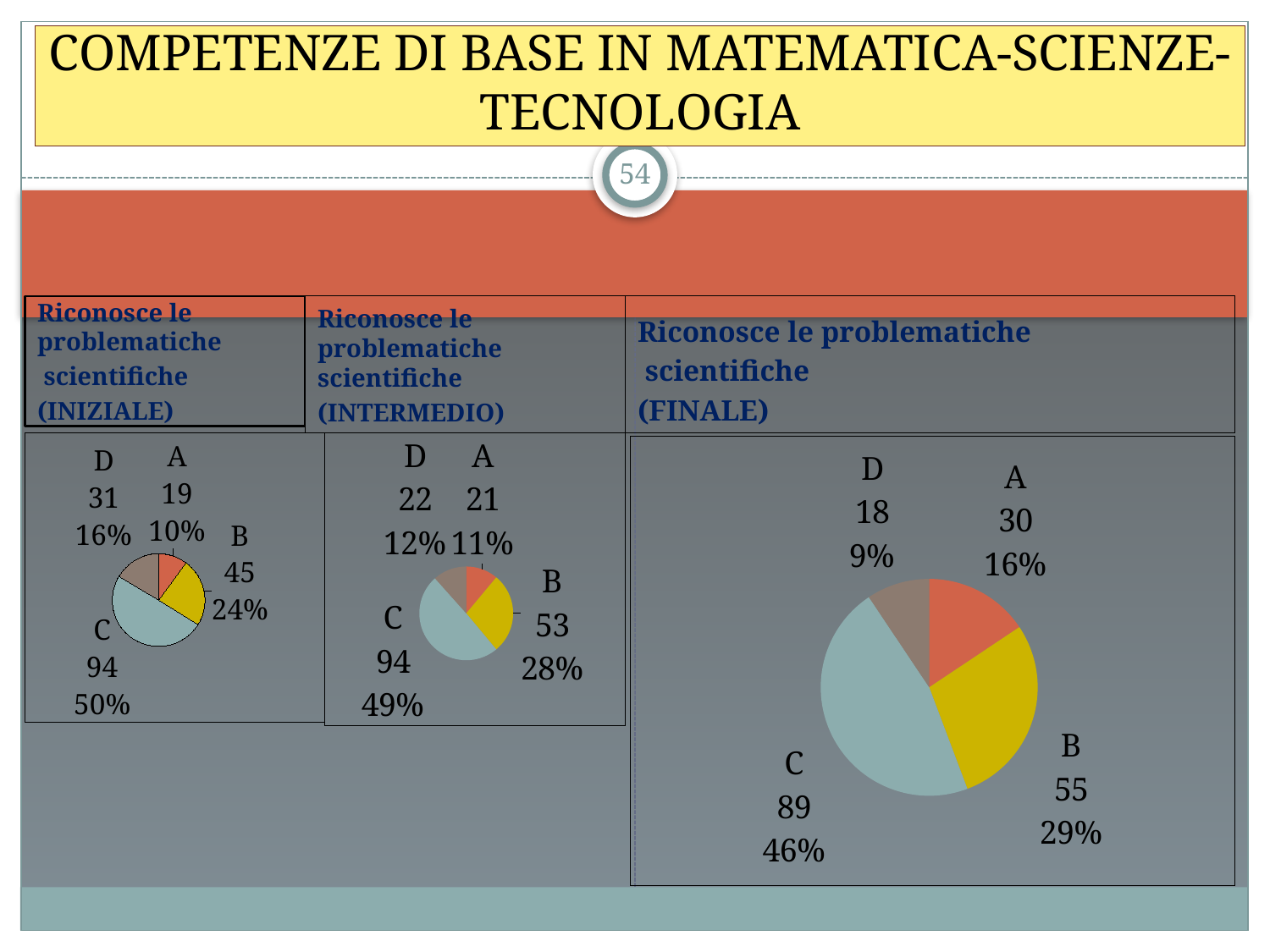
In the INTERMEDIO pie chart, what is the value for category B? 53 How many categories does the INTERMEDIO pie chart show? 4 In the FINALE pie chart, which category has the largest value? C In the INTERMEDIO pie chart, which category has the smallest value? A In the INTERMEDIO pie chart, what is the difference between the values for C and D? 72 In the FINALE pie chart, what is the value for category D? 18 In the FINALE pie chart, what is the difference between the values for B and A? 25 In the INIZIALE pie chart, what is the value for category C? 94 What kind of chart is used for the FINALE data? Pie chart In the FINALE pie chart, what share of the pie does category C represent? 46% In the INIZIALE pie chart, what share of the pie does category B represent? 24% In the INIZIALE pie chart, which is larger, the value for D or the value for A? D